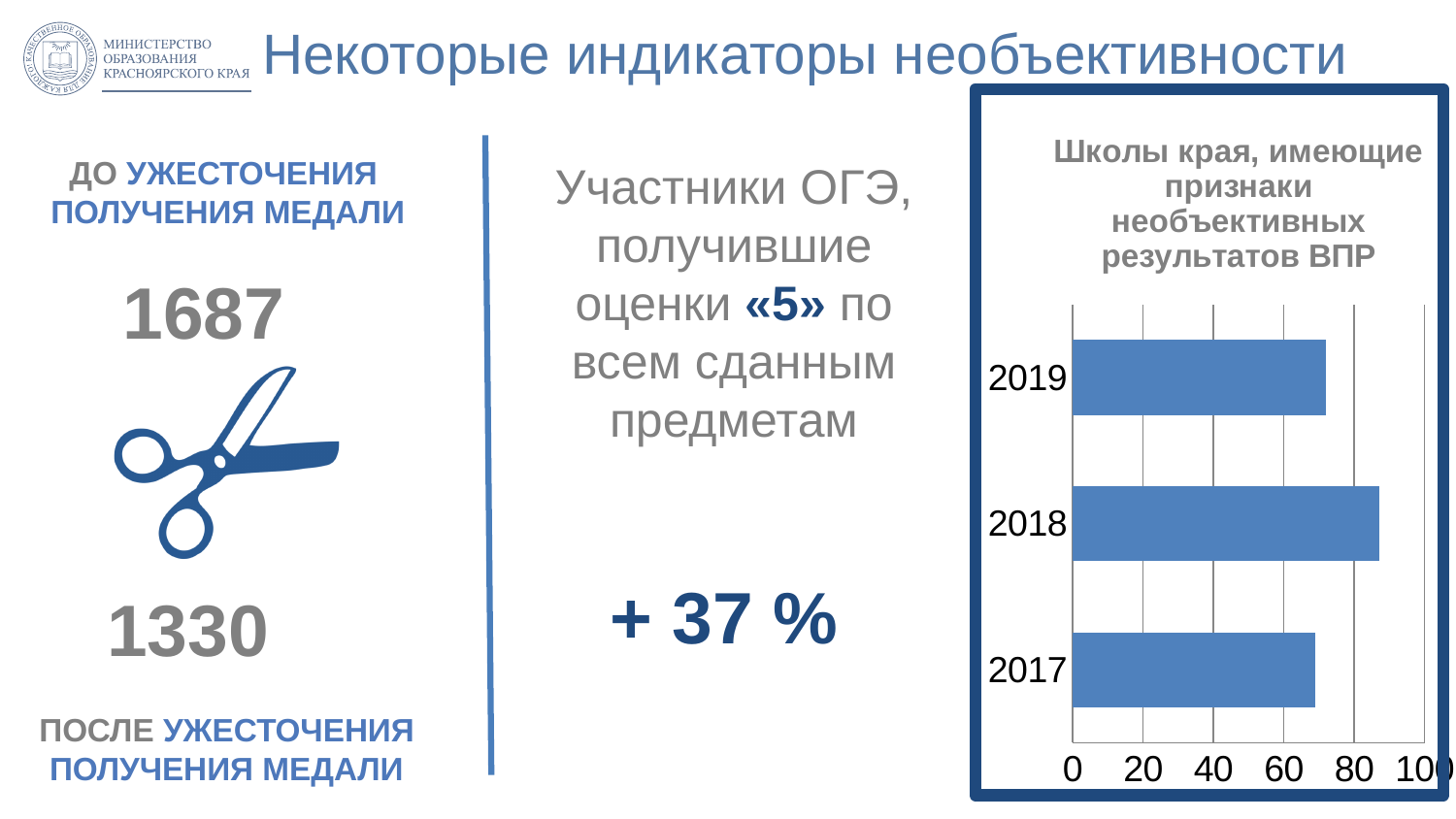
Which year has the highest value in the chart? 2018 How many years (categories) are plotted in the chart? 3 Which is larger, the value for 2018 or the value for 2019? 2018 What is the title of the chart? Школы края, имеющие признаки необъективных результатов ВПР Is the value for 2018 greater or less than 80? greater Is the value for 2019 greater or less than 80? less What is the maximum value shown on the chart's value axis? 100 Is the value for 2017 greater or less than 80? less Which is larger, the value for 2018 or the value for 2017? 2018 What kind of chart is shown on the slide? bar chart